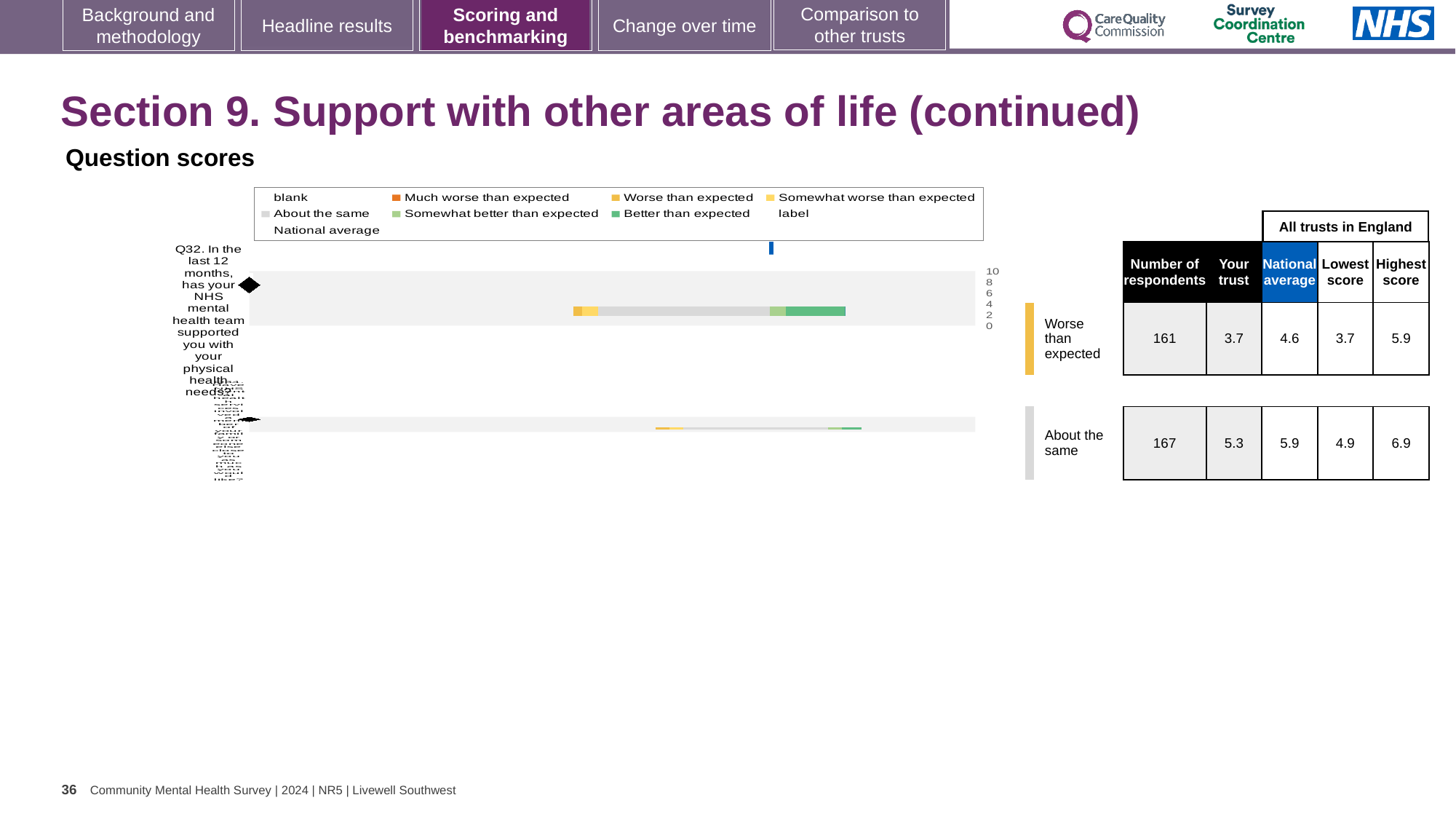
What is the highest score among all trusts in England for Q32? 5.9 How many respondents answered Q32? 161 How many question rows are plotted in the chart? 2 What is the 'Your trust' score for the second question row (rated 'About the same')? 5.3 What is the 'Your trust' score for Q32? 3.7 What is the difference between the highest and lowest scores for Q32? 2.2 Which row has more respondents, Q32 or the second question row? the second question row What kind of chart is shown on the slide? bar chart How much higher is the national average than the 'Your trust' score for Q32? 0.9 What is the national average score for Q32? 4.6 Which benchmark category is the second question row rated as? About the same Which benchmark category is Q32 rated as? Worse than expected